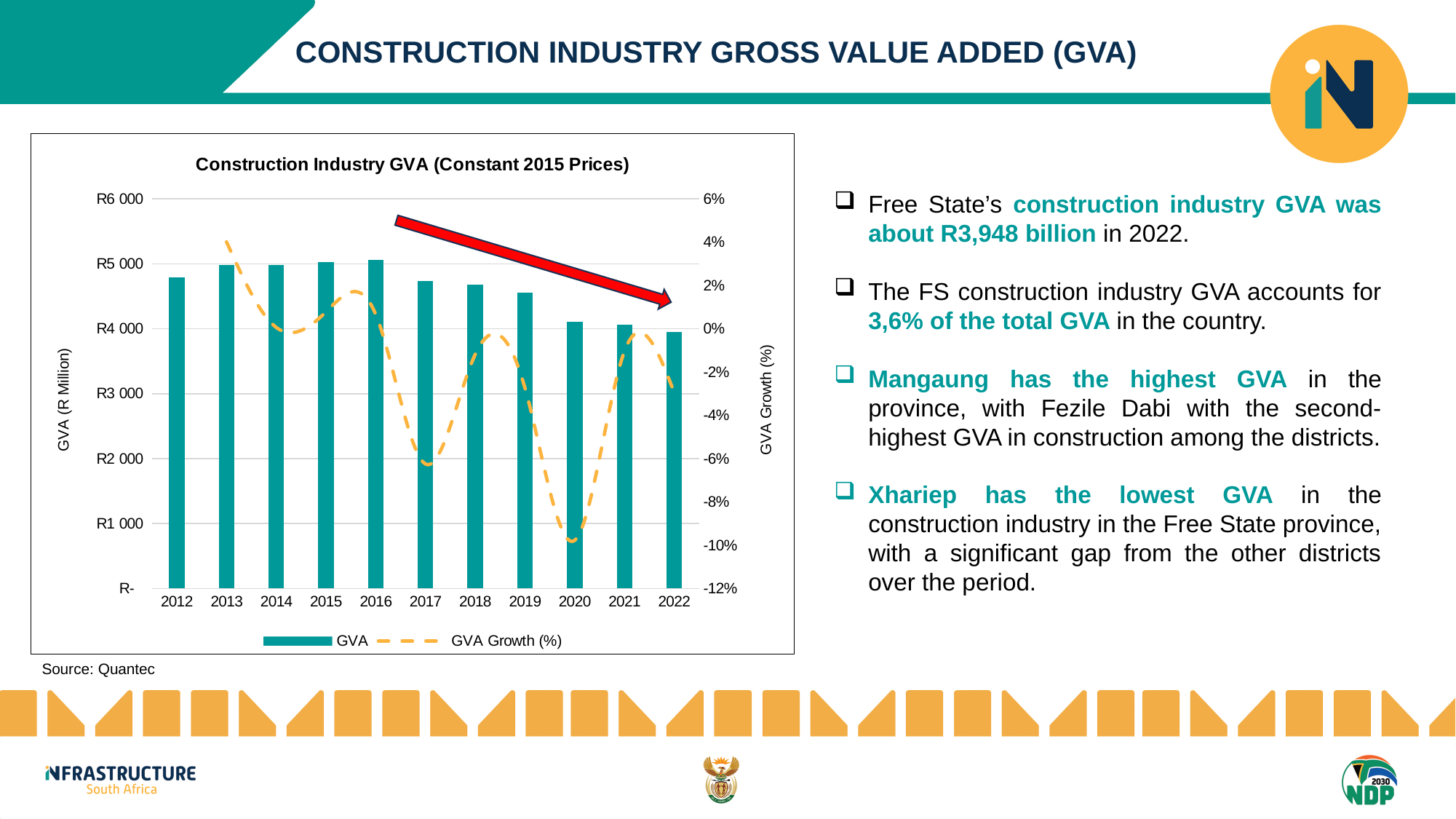
Which year has the larger GVA bar, 2012 or 2022? 2012 Do the GVA bars generally rise or fall from 2016 to 2022? fall Is the GVA Growth (%) value for 2013 greater or less than 2%? greater In which year is the GVA Growth (%) line at its lowest in the Construction Industry GVA chart? 2020 Is the GVA value for 2012 greater or less than R4 000? greater How many series does the legend of the Construction Industry GVA chart list? 2 What is the title of the chart on the slide? Construction Industry GVA (Constant 2015 Prices) In which year is the GVA Growth (%) line at its highest in the Construction Industry GVA chart? 2013 Is the GVA Growth (%) value for 2020 greater or less than -8%? less What kind of chart is used to show the GVA series in the Construction Industry GVA chart? bar chart How many years are shown on the x axis of the Construction Industry GVA chart? 11